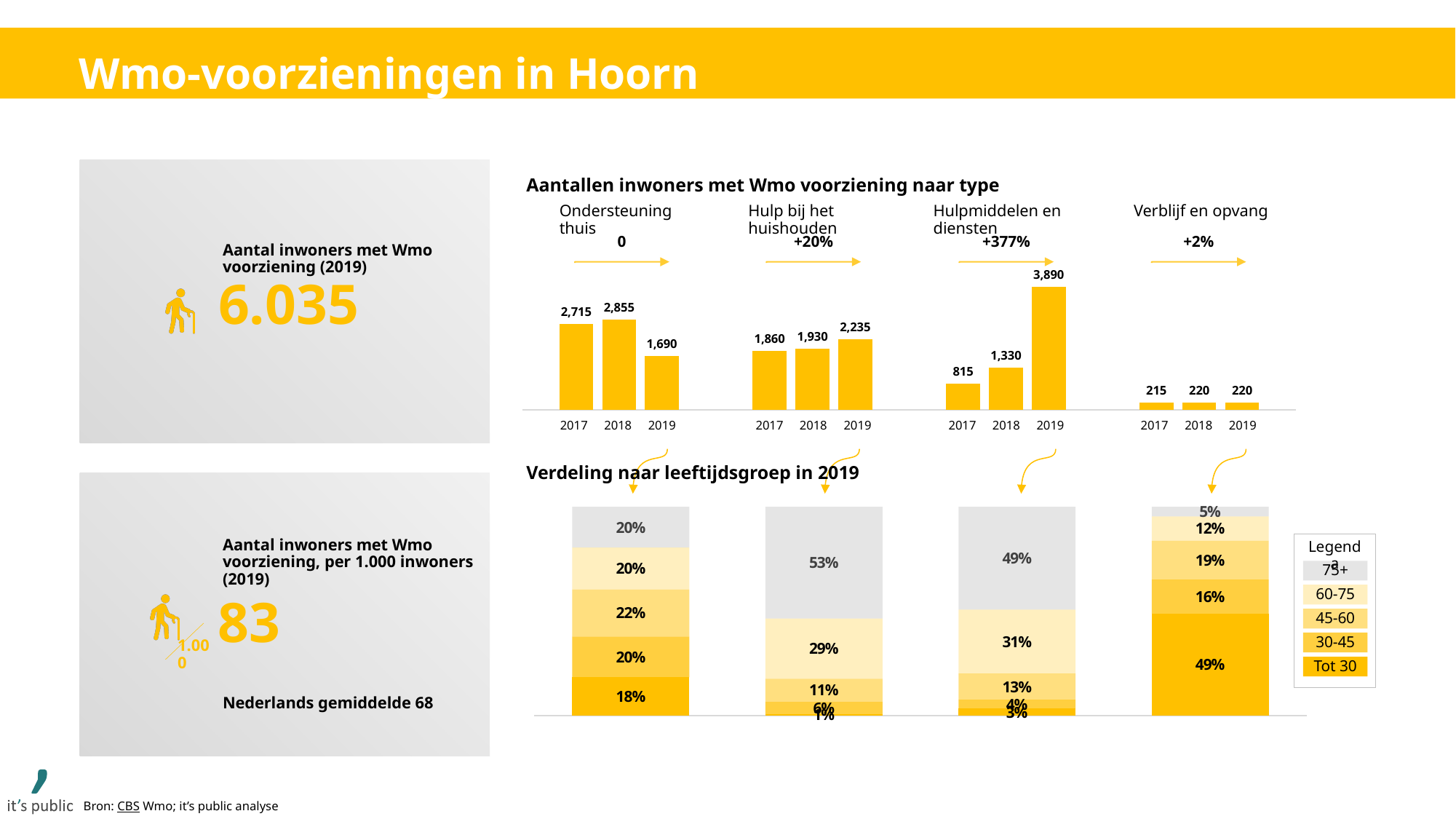
In the chart 'Aantallen inwoners met Wmo voorziening naar type', do the values for Hulpmiddelen en diensten rise or fall from 2017 to 2019? Rise How many age groups does the legend of the chart 'Verdeling naar leeftijdsgroep in 2019' list? 5 What kind of chart is 'Aantallen inwoners met Wmo voorziening naar type'? Bar chart In the chart 'Aantallen inwoners met Wmo voorziening naar type', what is the difference between the 2019 and 2018 values for Hulpmiddelen en diensten? 2,560 In the chart 'Verdeling naar leeftijdsgroep in 2019', what is the value for the Tot 30 age group in the Verblijf en opvang bar? 49% In the chart 'Aantallen inwoners met Wmo voorziening naar type', what is the value for Ondersteuning thuis in 2017? 2,715 In the chart 'Aantallen inwoners met Wmo voorziening naar type', what is the value for Hulpmiddelen en diensten in 2019? 3,890 In the chart 'Aantallen inwoners met Wmo voorziening naar type', which year has the highest value for Hulp bij het huishouden? 2019 In the chart 'Verdeling naar leeftijdsgroep in 2019', what share of the Hulp bij het huishouden bar is the 75+ age group? 53% In the chart 'Aantallen inwoners met Wmo voorziening naar type', which year has the lowest value for Ondersteuning thuis? 2019 In the chart 'Aantallen inwoners met Wmo voorziening naar type', what is the value for Verblijf en opvang in 2017? 215 In the chart 'Aantallen inwoners met Wmo voorziening naar type', which is larger in 2019: Ondersteuning thuis or Hulp bij het huishouden? Hulp bij het huishouden